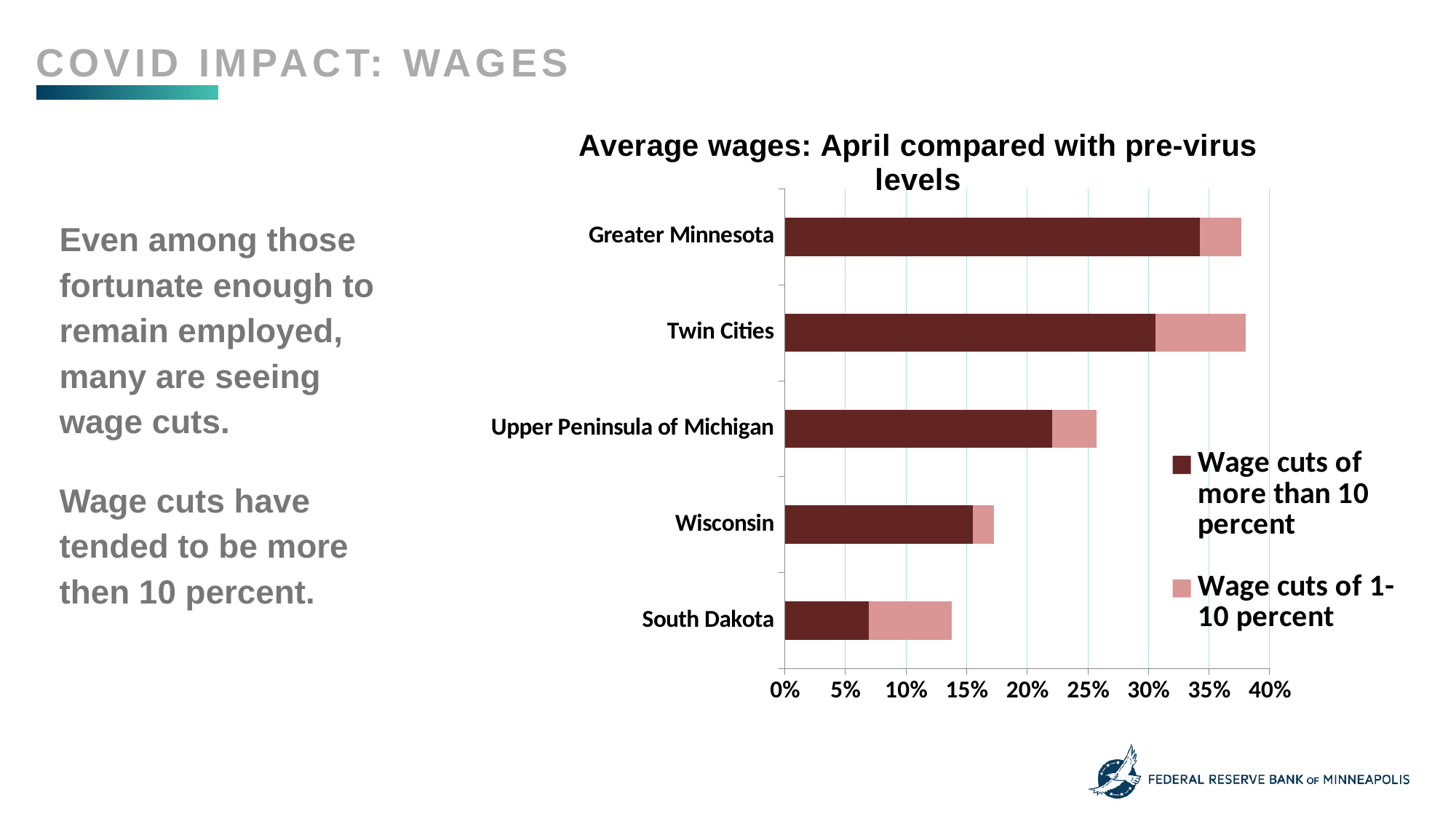
What kind of chart is shown on the slide? bar chart Is the value for wage cuts of more than 10 percent in South Dakota greater or less than 10%? less Is the value for wage cuts of more than 10 percent in Wisconsin greater or less than 20%? less Which region has the largest share of workers with wage cuts of more than 10 percent? Greater Minnesota Which has a larger share of wage cuts of more than 10 percent, Wisconsin or Upper Peninsula of Michigan? Upper Peninsula of Michigan Which series is shown in the lighter pink colour? Wage cuts of 1-10 percent How many series does the chart's legend list? 2 How many regions are shown on the chart? 5 Which region has the smallest share of workers with wage cuts of more than 10 percent? South Dakota Which has a larger share of wage cuts of 1-10 percent, Twin Cities or Greater Minnesota? Twin Cities What is the title of the chart? Average wages: April compared with pre-virus levels Is the value for wage cuts of more than 10 percent in Greater Minnesota greater or less than 30%? greater